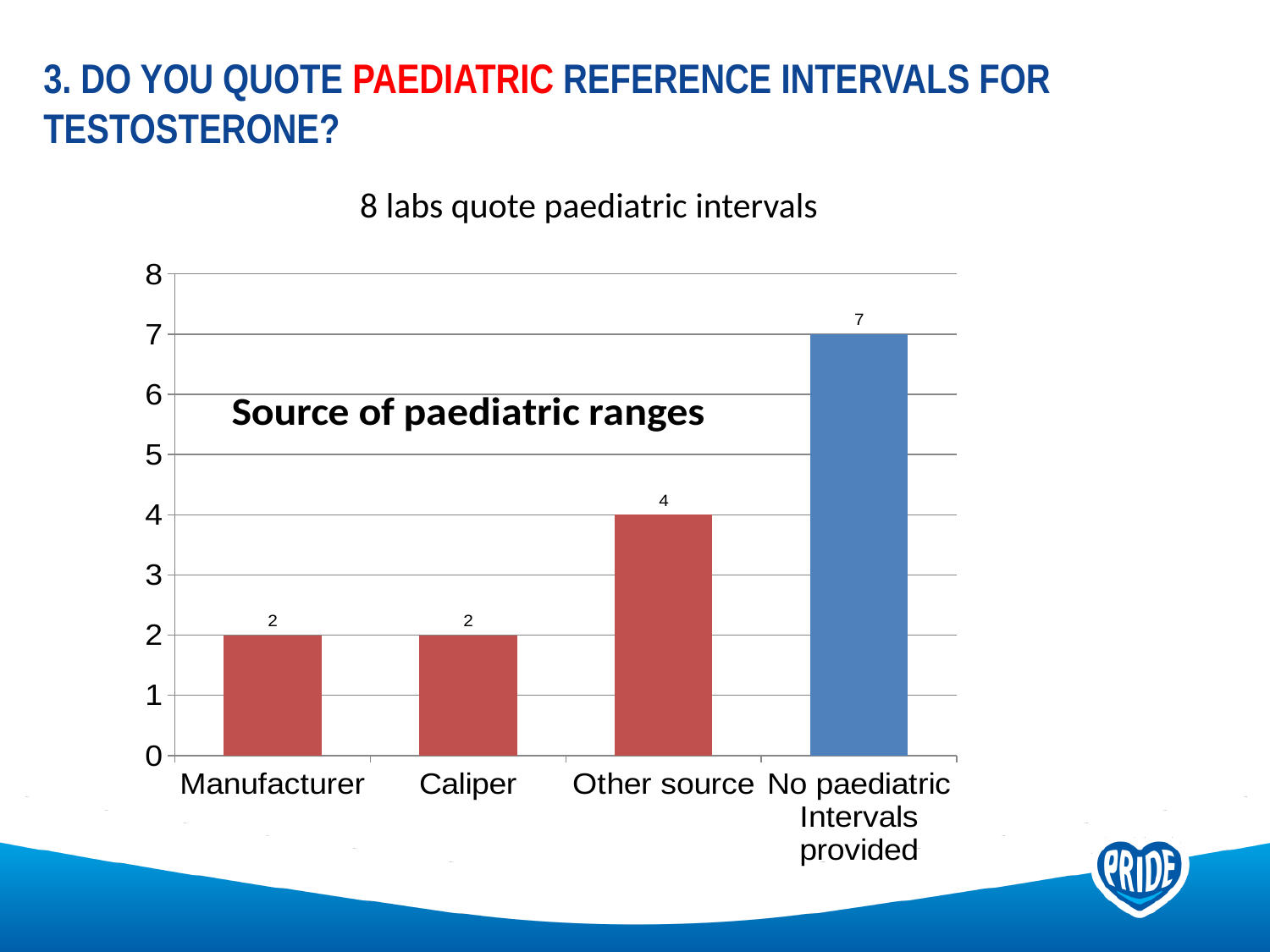
Which is larger, the value for Other source or the value for Manufacturer? Other source What is the value for Caliper? 2 What is the title of the chart? Source of paediatric ranges Is the value for No paediatric Intervals provided greater or less than 5? greater What is the value for No paediatric Intervals provided? 7 What is the value for Manufacturer? 2 What kind of chart is shown? bar chart What is the difference between the values for No paediatric Intervals provided and Other source? 3 How many categories are shown on the x axis? 4 What is the difference between the values for Other source and Caliper? 2 What is the value for Other source? 4 Which category has the highest value? No paediatric Intervals provided